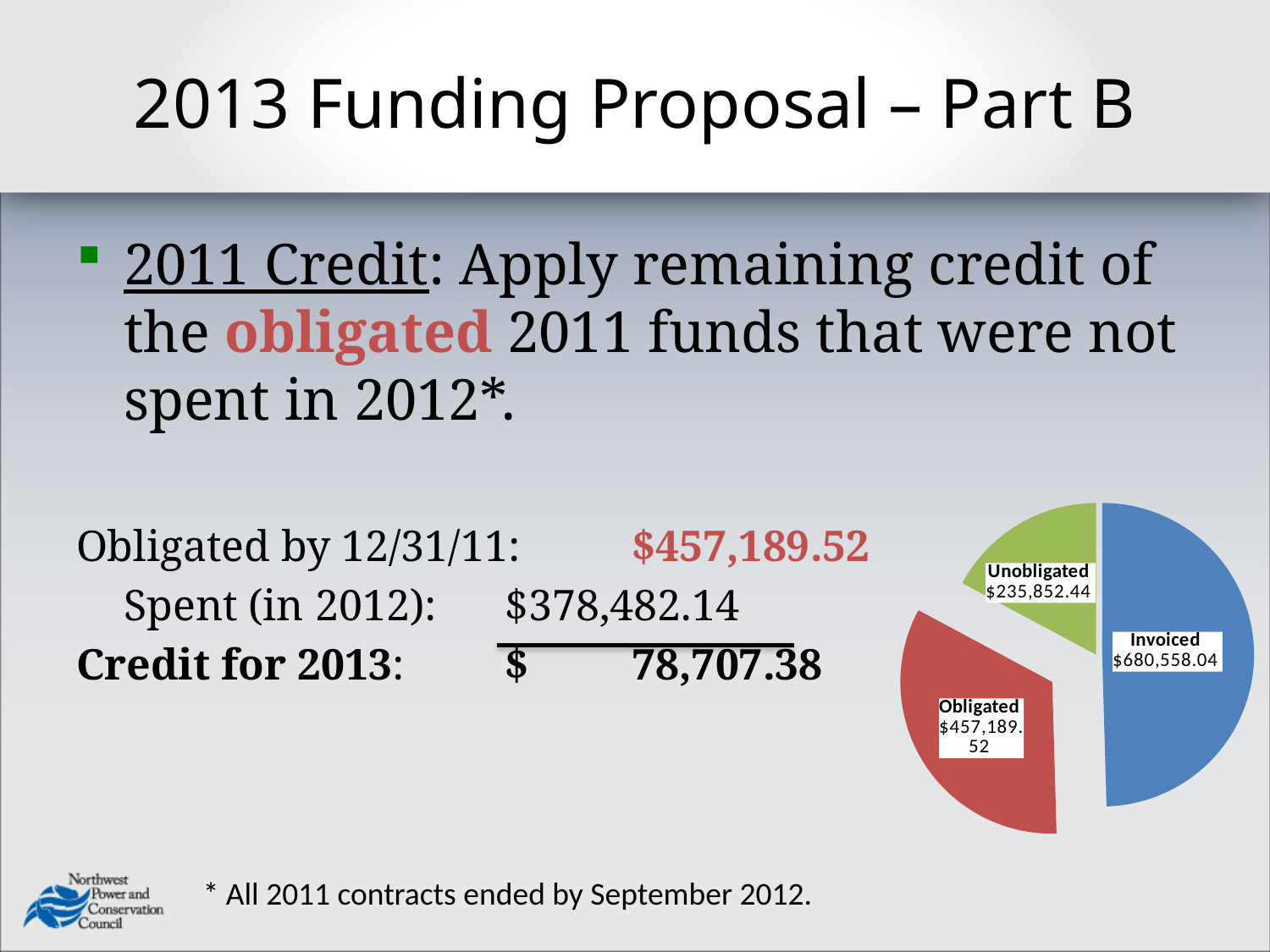
What kind of chart is shown on the slide? Pie chart What is the difference between the Obligated and Unobligated values in the pie chart? $221,337.08 What is the value of the Invoiced slice in the pie chart? $680,558.04 What is the total of all three slices in the pie chart? $1,373,600.00 What is the value of the Unobligated slice in the pie chart? $235,852.44 In the pie chart, which is larger: Obligated or Unobligated? Obligated What colour is the Obligated slice in the pie chart? Red Which slice of the pie chart has the smallest value? Unobligated How many slices does the pie chart have? 3 Which slice of the pie chart has the largest value? Invoiced What is the value of the Obligated slice in the pie chart? $457,189.52 What is the difference between the Invoiced and Obligated values in the pie chart? $223,368.52